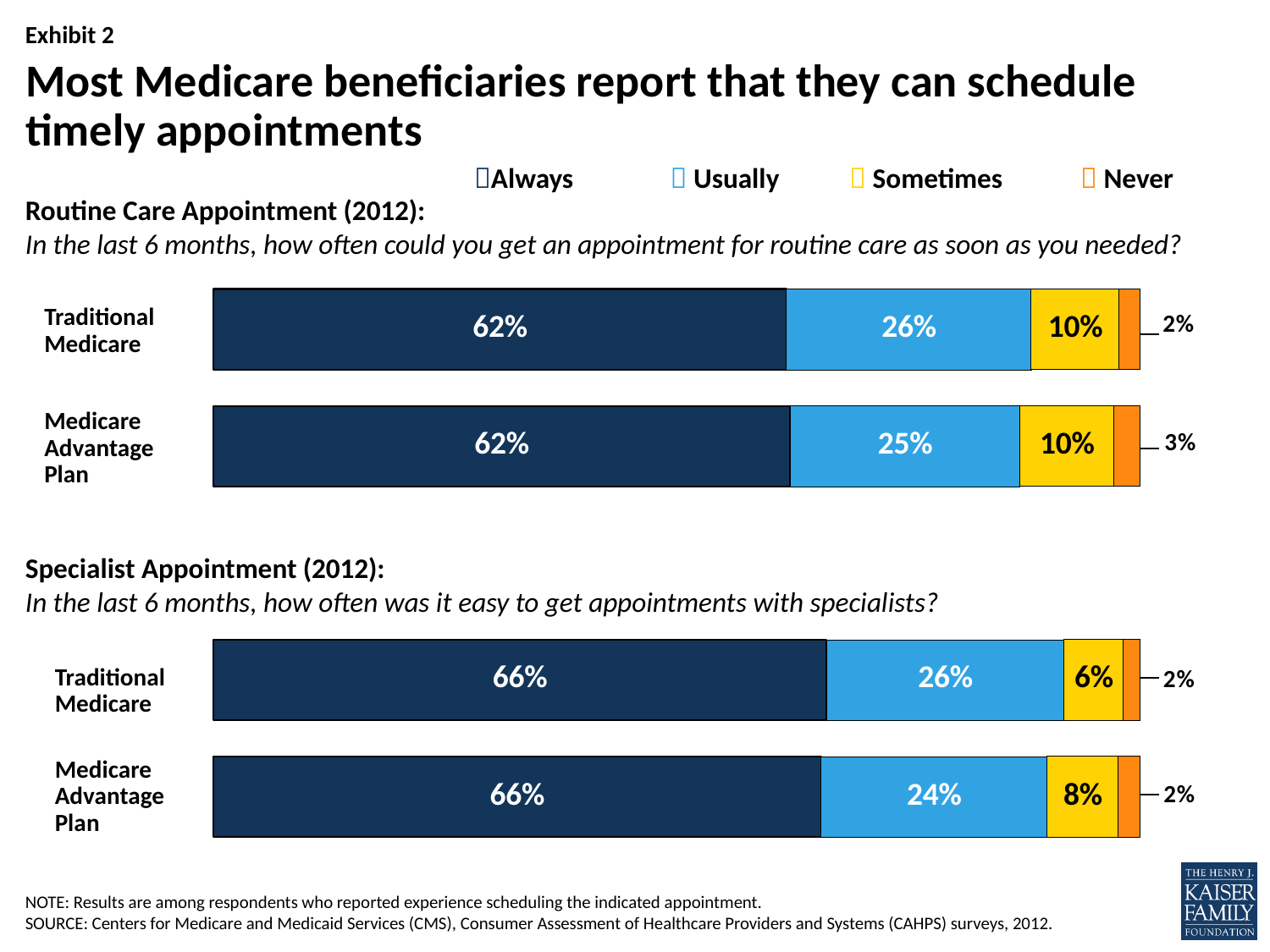
How many series does the legend list? 4 In the Specialist Appointment (2012) chart, what is the difference between the Sometimes values for Medicare Advantage Plan and Traditional Medicare? 2 percentage points In the Routine Care Appointment (2012) chart, what percentage of Medicare Advantage Plan beneficiaries answered Usually? 25% In the Specialist Appointment (2012) chart, what percentage of Traditional Medicare beneficiaries answered Sometimes? 6% In the Routine Care Appointment (2012) chart, which has the larger Usually value, Traditional Medicare or Medicare Advantage Plan? Traditional Medicare In the Routine Care Appointment (2012) chart, what percentage of Traditional Medicare beneficiaries answered Always? 62% In the Specialist Appointment (2012) chart, what percentage of Medicare Advantage Plan beneficiaries answered Usually? 24% In the Routine Care Appointment (2012) chart, what percentage of Medicare Advantage Plan beneficiaries answered Never? 3% How many categories are shown in the Specialist Appointment (2012) chart? 2 What kind of chart is used for the Routine Care Appointment (2012) data? Stacked bar chart In the Routine Care Appointment (2012) chart, what is the total of the Always and Usually segments for Traditional Medicare? 88% In the Specialist Appointment (2012) chart, which has the larger Sometimes value, Traditional Medicare or Medicare Advantage Plan? Medicare Advantage Plan